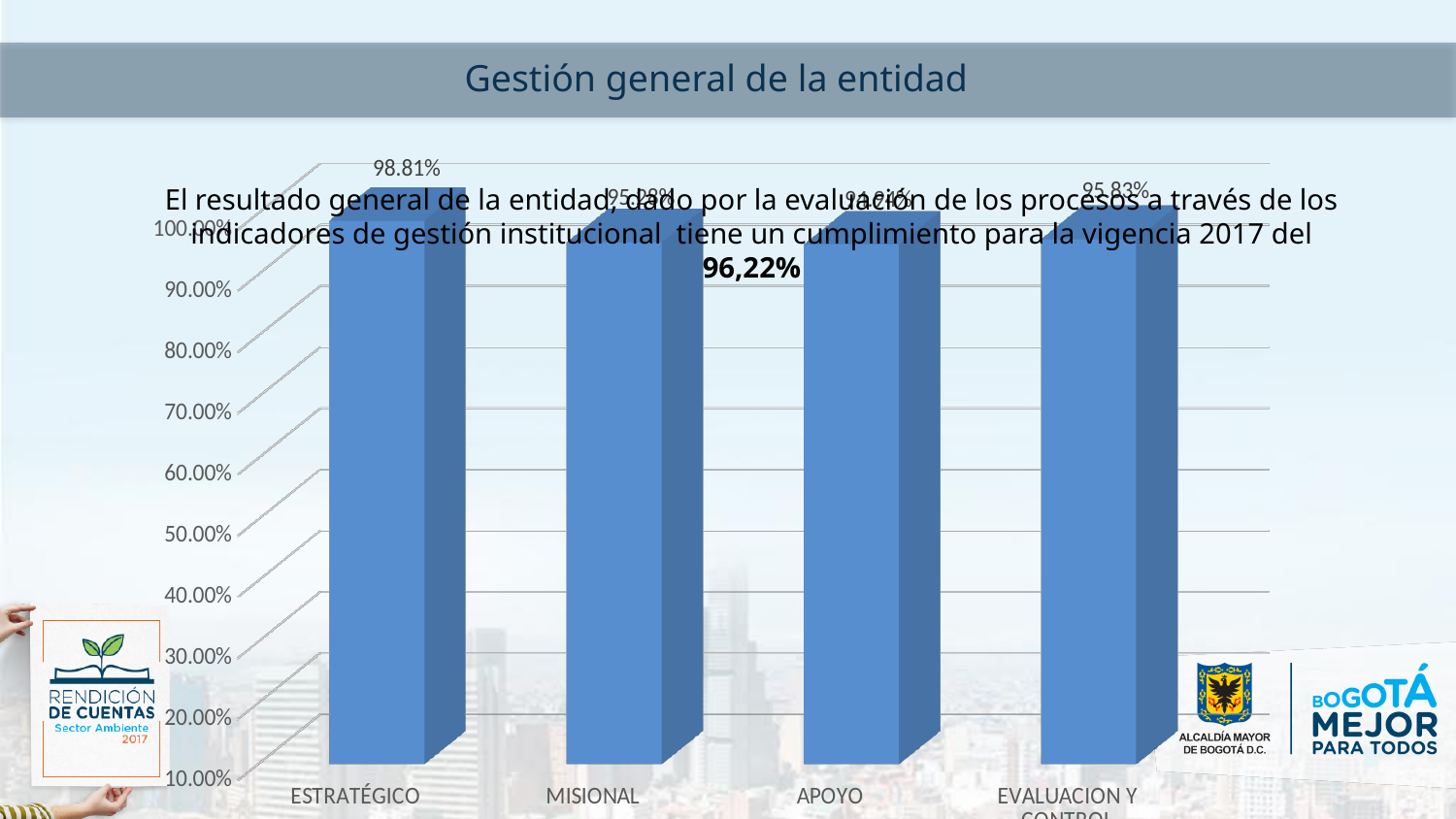
Which is larger, the value for ESTRATÉGICO or the value for EVALUACION Y CONTROL? ESTRATÉGICO Which category has the highest value? ESTRATÉGICO What is the title shown at the top of the slide above the chart? Gestión general de la entidad How many categories are shown on the x axis of the chart? 4 What is the value for ESTRATÉGICO? 98.81% What type of chart is shown on the slide? bar chart What is the lowest tick label shown on the vertical axis? 10.00% Is the value for APOYO greater or less than 80.00%? greater What is the value for EVALUACION Y CONTROL? 95.83% What is the difference between the values for ESTRATÉGICO and EVALUACION Y CONTROL? 2.98% Is the value for MISIONAL greater or less than 90.00%? greater